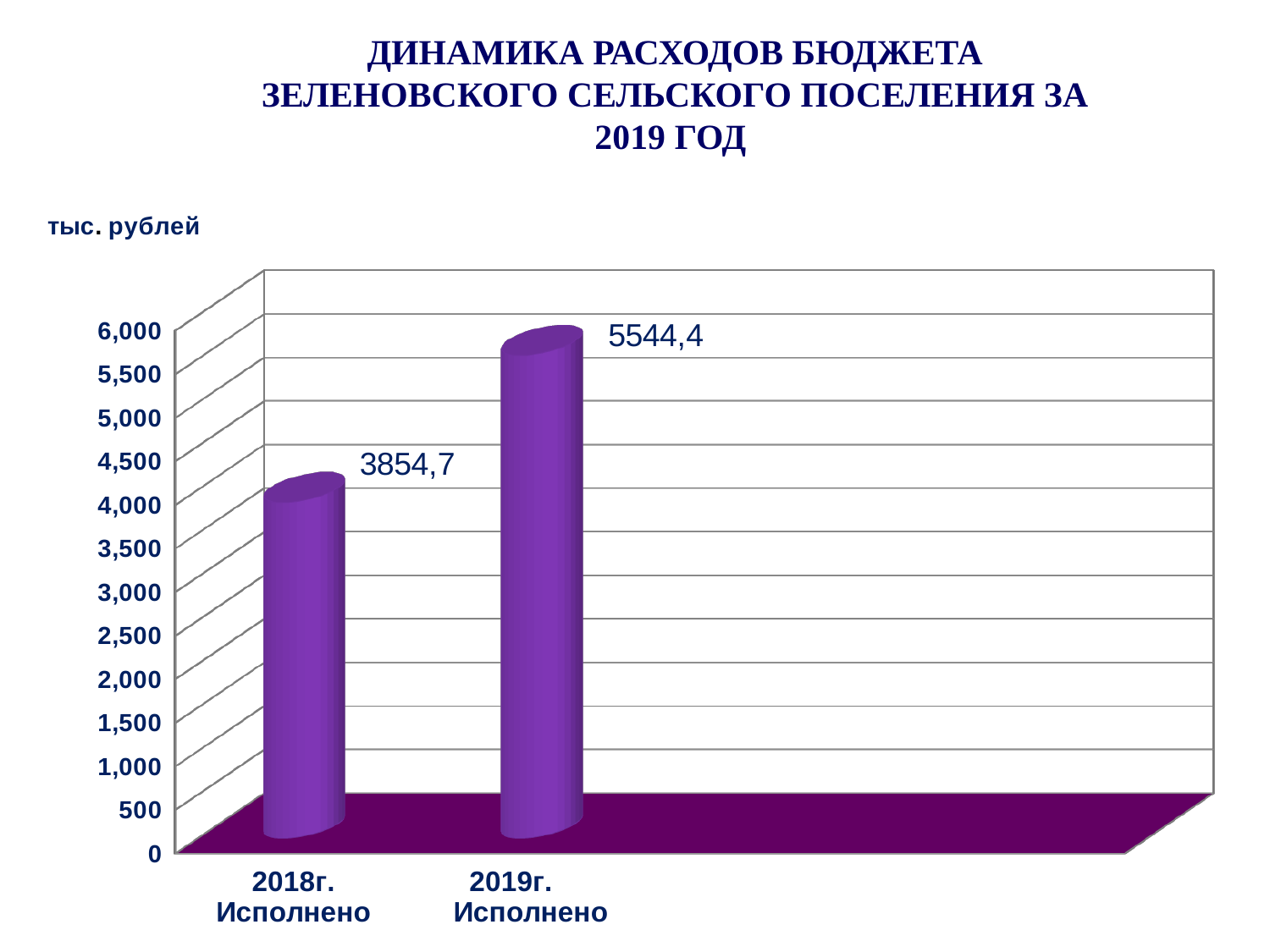
Which category has the lowest value? 2018г. Исполнено Which category has the highest value? 2019г. Исполнено What is the value for 2019г. Исполнено? 5544,4 What kind of chart is shown on the slide? bar chart Do the values rise or fall from 2018г. to 2019г.? rise How many categories are shown on the chart? 2 What unit is indicated for the values on the chart? тыс. рублей Which is larger, the value for 2018г. Исполнено or 2019г. Исполнено? 2019г. Исполнено What is the value for 2018г. Исполнено? 3854,7 Is the value for 2018г. Исполнено greater or less than 4,000? less Is the value for 2019г. Исполнено greater or less than 5,000? greater What is the difference between the values for 2019г. Исполнено and 2018г. Исполнено? 1689,7